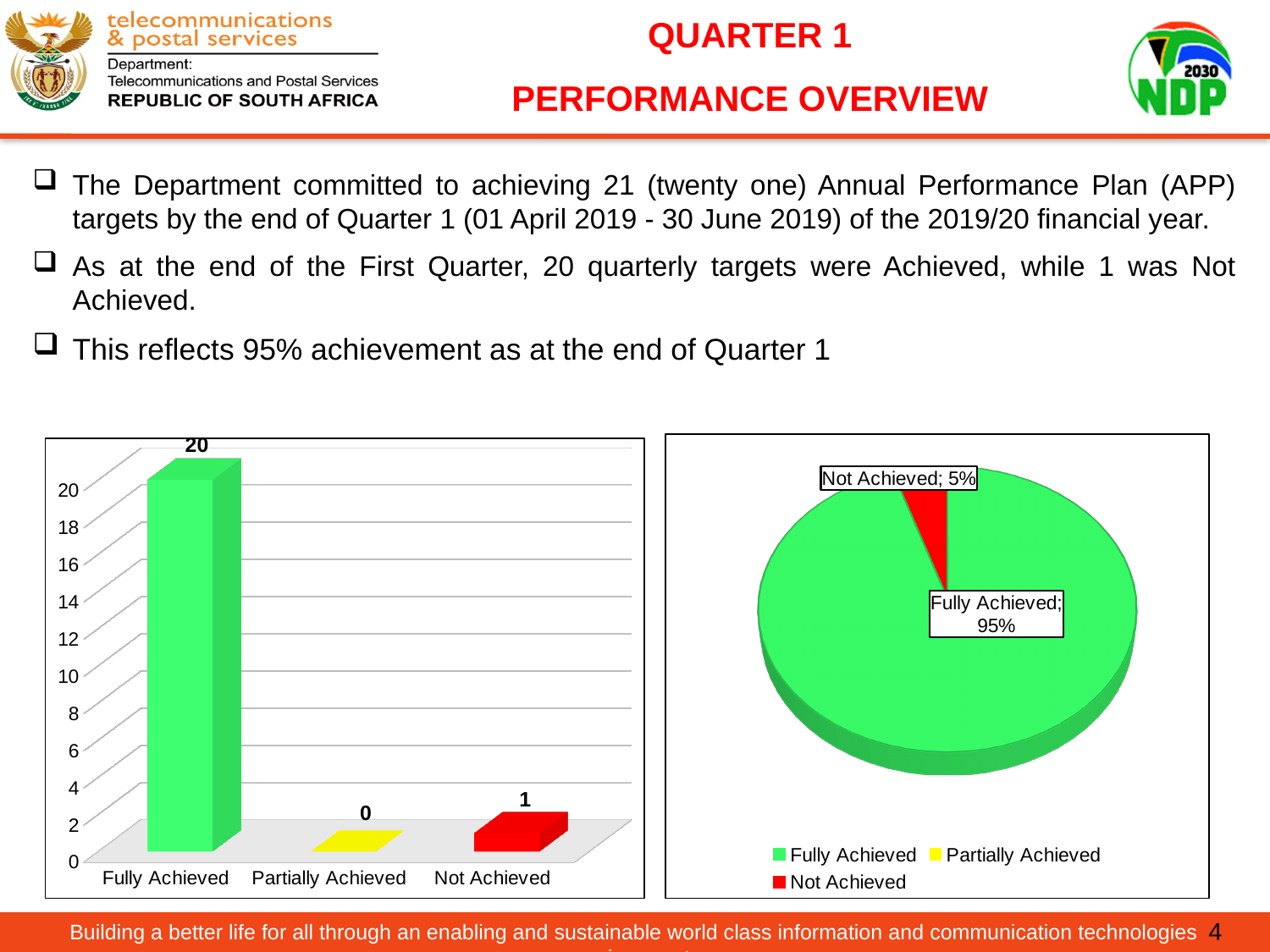
How many categories are shown on the x axis of the bar chart on the left? 3 What kind of chart is the chart on the left? Bar chart In the bar chart on the left, what is the value for Partially Achieved? 0 In the bar chart on the left, which category has the highest value? Fully Achieved In the bar chart on the left, what is the value for Not Achieved? 1 In the bar chart on the left, which category has the lowest value? Partially Achieved In the bar chart on the left, which is larger: Fully Achieved or Not Achieved? Fully Achieved In the bar chart on the left, what is the value for Fully Achieved? 20 In the pie chart on the right, what share does Fully Achieved have? 95% In the bar chart on the left, what is the difference between the Fully Achieved and Not Achieved values? 19 In the pie chart on the right, what share does Not Achieved have? 5% How many entries does the legend of the pie chart on the right list? 3